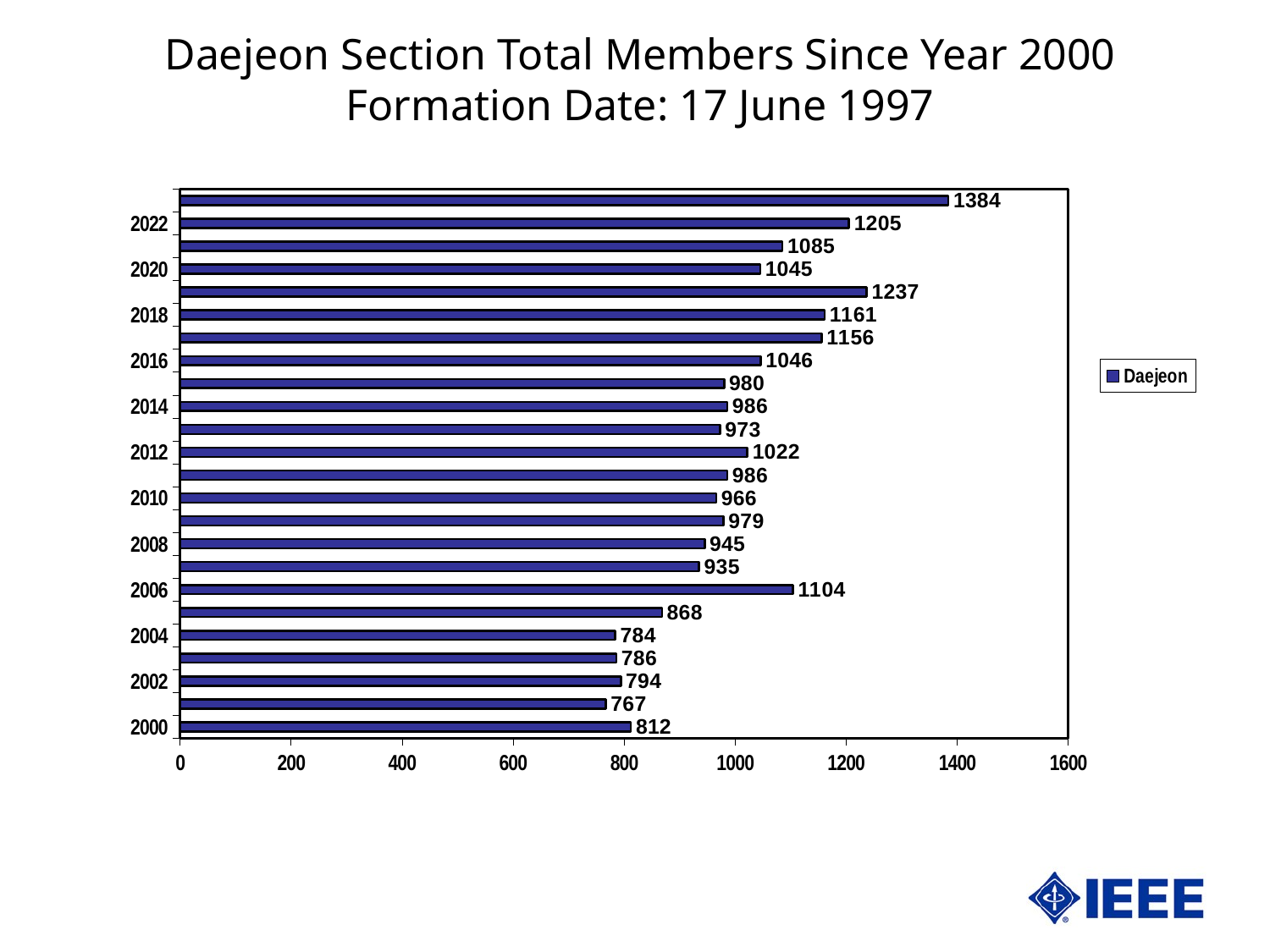
What is the value for 2000? 812 How many series does the legend list? 1 Which is larger, the value for 2016 or the value for 2012? 2016 What is the value for 2006? 1104 What is the lowest value shown on the chart? 767 How many bars are plotted on the chart? 24 What is the highest value shown on the chart? 1384 What is the value for 2018? 1161 What is the value for 2022? 1205 What is the difference between the values for 2022 and 2020? 160 What kind of chart is shown on the slide? bar chart What series name appears in the legend? Daejeon